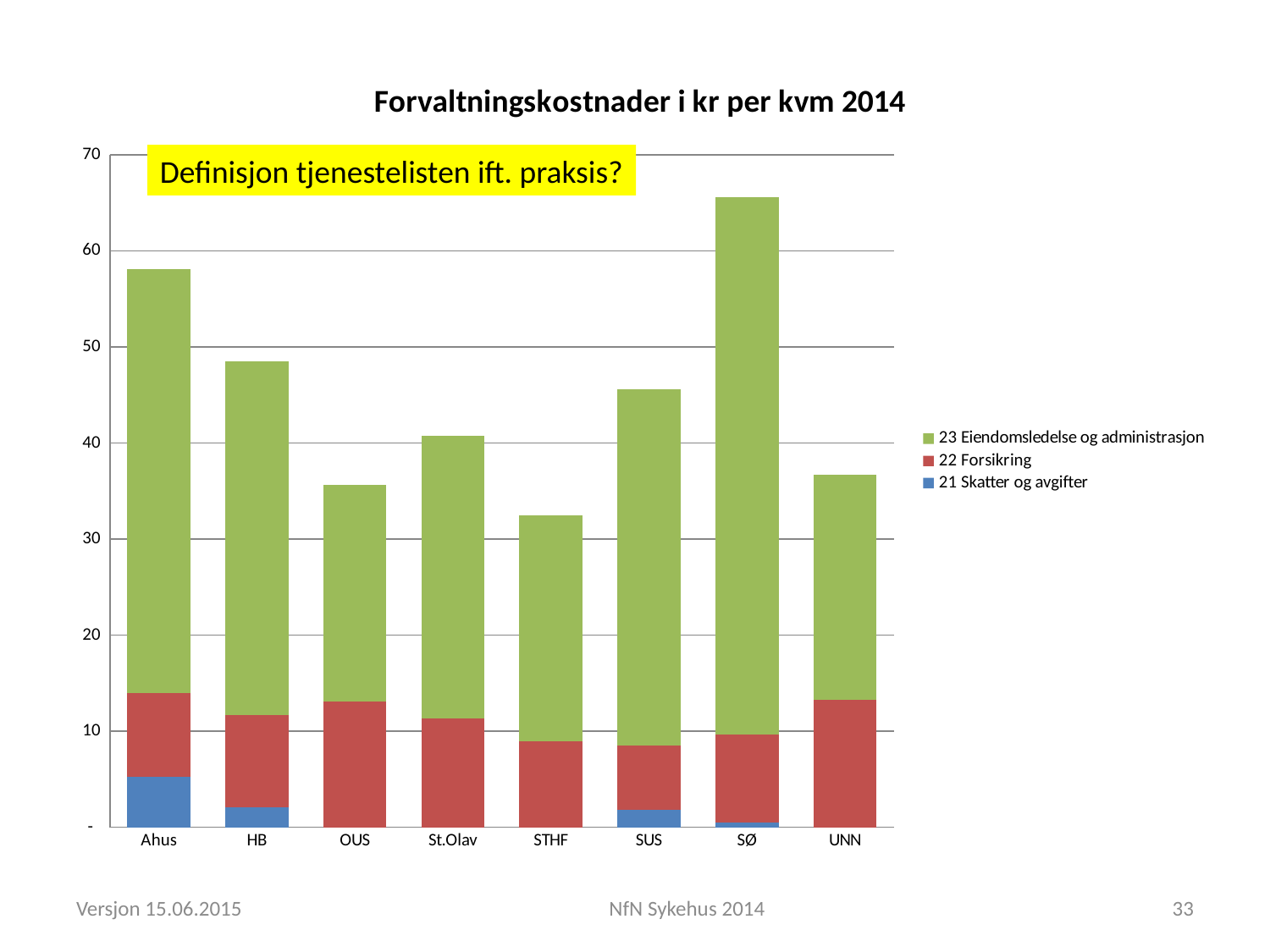
Which hospital has the lowest total forvaltningskostnader per kvm? STHF Is the total value for STHF greater or less than 40? less What kind of chart is shown on the slide? Stacked bar chart How many series does the legend list? 3 Which hospital has the highest total forvaltningskostnader per kvm? SØ Which has the larger total, Ahus or HB? Ahus What is the title of the chart? Forvaltningskostnader i kr per kvm 2014 Is the total value for SØ greater or less than 60? greater How many hospitals (categories) are shown on the x axis? 8 Is the total value for UNN greater or less than 40? less Which hospital has the largest '21 Skatter og avgifter' segment? Ahus